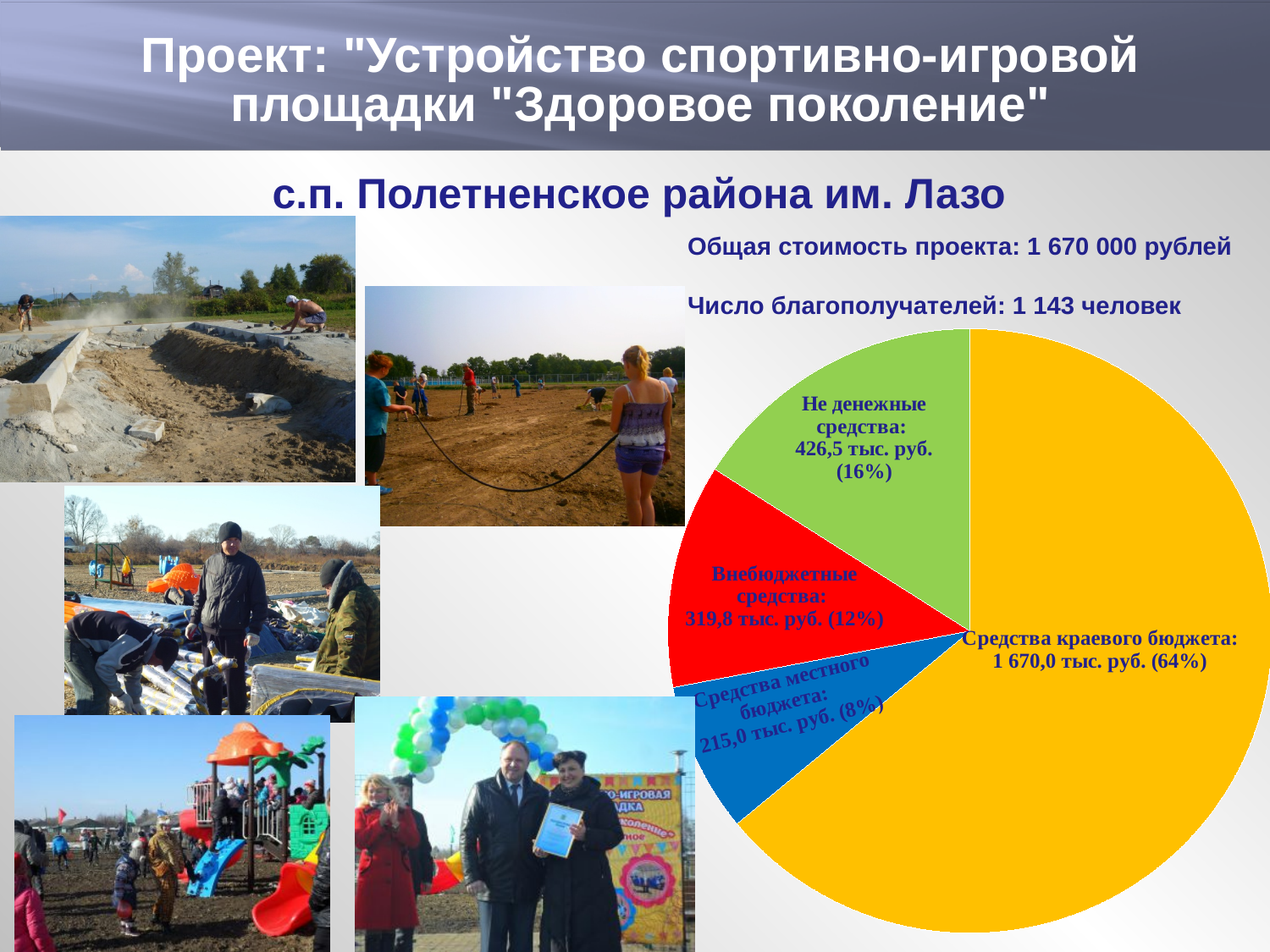
What share of the pie does Внебюджетные средства represent? 12% What colour is the Средства краевого бюджета slice in the pie chart? yellow How many slices does the pie chart have? 4 Which slice of the pie chart is the smallest? Средства местного бюджета What share of the pie does Не денежные средства represent? 16% What is the value for Средства краевого бюджета in the pie chart? 1 670,0 тыс. руб. Which is larger in the pie chart: Внебюджетные средства or Средства местного бюджета? Внебюджетные средства What is the value for Внебюджетные средства in the pie chart? 319,8 тыс. руб. Which slice of the pie chart is the largest? Средства краевого бюджета What is the value for Средства местного бюджета in the pie chart? 215,0 тыс. руб. What kind of chart is shown on the slide? pie chart What is the value for Не денежные средства in the pie chart? 426,5 тыс. руб.